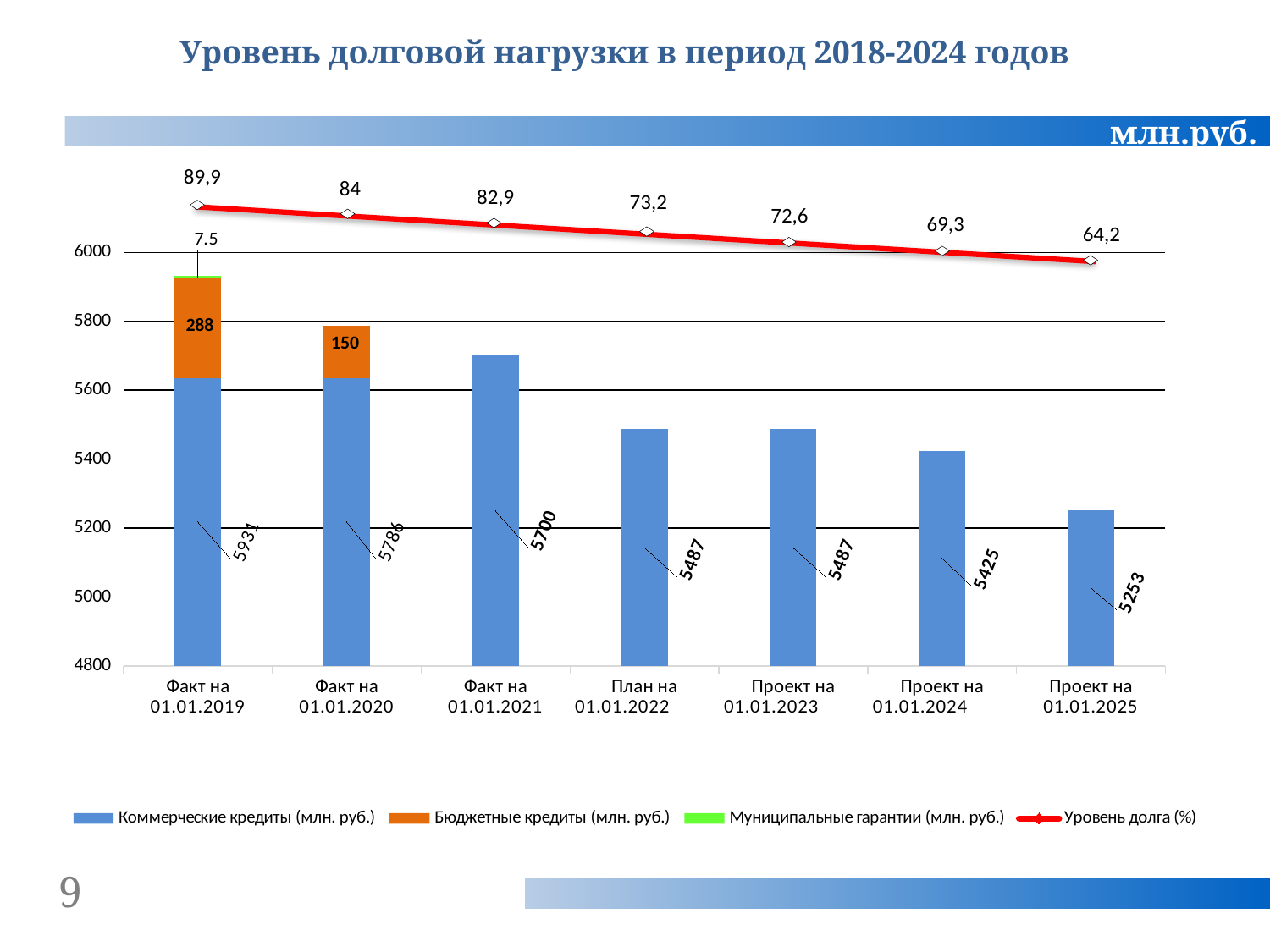
What is the value of Муниципальные гарантии for Факт на 01.01.2019? 7.5 Is the Коммерческие кредиты bar for Проект на 01.01.2025 greater or less than 5400? less What is the value of Уровень долга (%) for Проект на 01.01.2025? 64,2 Which category has the highest Уровень долга (%)? Факт на 01.01.2019 Does the Уровень долга (%) line rise or fall from 01.01.2019 to 01.01.2025? It falls How many categories are shown on the x axis? 7 What is the value of Уровень долга (%) for Факт на 01.01.2019? 89,9 What value is labelled on the bar for Факт на 01.01.2021? 5700 What is the difference between Уровень долга (%) for Факт на 01.01.2019 and Проект на 01.01.2025? 25,7 How many series does the legend list? 4 What kind of chart is shown on the slide? A combined bar and line chart (stacked bars with a line) What is the value of Бюджетные кредиты for Факт на 01.01.2020? 150